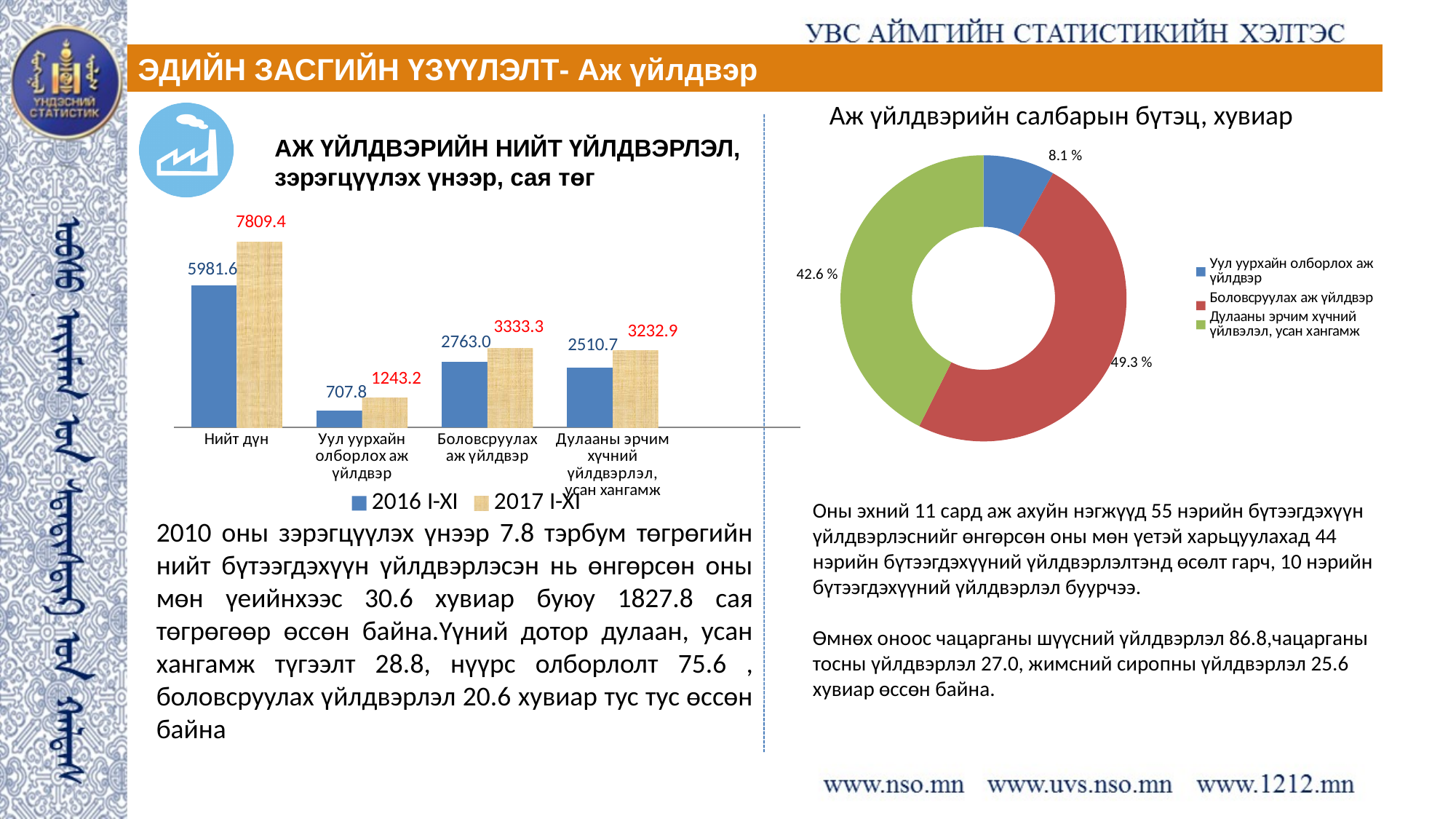
What kind of chart is the chart on the left of the slide? Bar chart How many categories are shown on the x axis of the bar chart on the left? 4 In the bar chart on the left, what is the value for Нийт дүн in 2017 I-XI? 7809.4 In the bar chart on the left, what is the difference between the 2017 I-XI and 2016 I-XI values for Нийт дүн? 1827.8 In the bar chart on the left, which category has the lowest value in 2017 I-XI? Уул уурхайн олборлох аж үйлдвэр In the doughnut chart titled 'Аж үйлдвэрийн салбарын бүтэц, хувиар', which sector has the smallest share? Уул уурхайн олборлох аж үйлдвэр In the bar chart on the left, which is larger for Дулааны эрчим хүчний үйлдвэрлэл, усан хангамж: the 2016 I-XI value or the 2017 I-XI value? 2017 I-XI How many series does the legend of the bar chart on the left list? 2 In the bar chart on the left, what is the value for Боловсруулах аж үйлдвэр in 2017 I-XI? 3333.3 In the bar chart on the left, what is the value for Уул уурхайн олборлох аж үйлдвэр in 2016 I-XI? 707.8 In the doughnut chart titled 'Аж үйлдвэрийн салбарын бүтэц, хувиар', what share does Боловсруулах аж үйлдвэр have? 49.3 % In the doughnut chart titled 'Аж үйлдвэрийн салбарын бүтэц, хувиар', what colour represents Дулааны эрчим хүчний үйлвэлэл, усан хангамж? Green